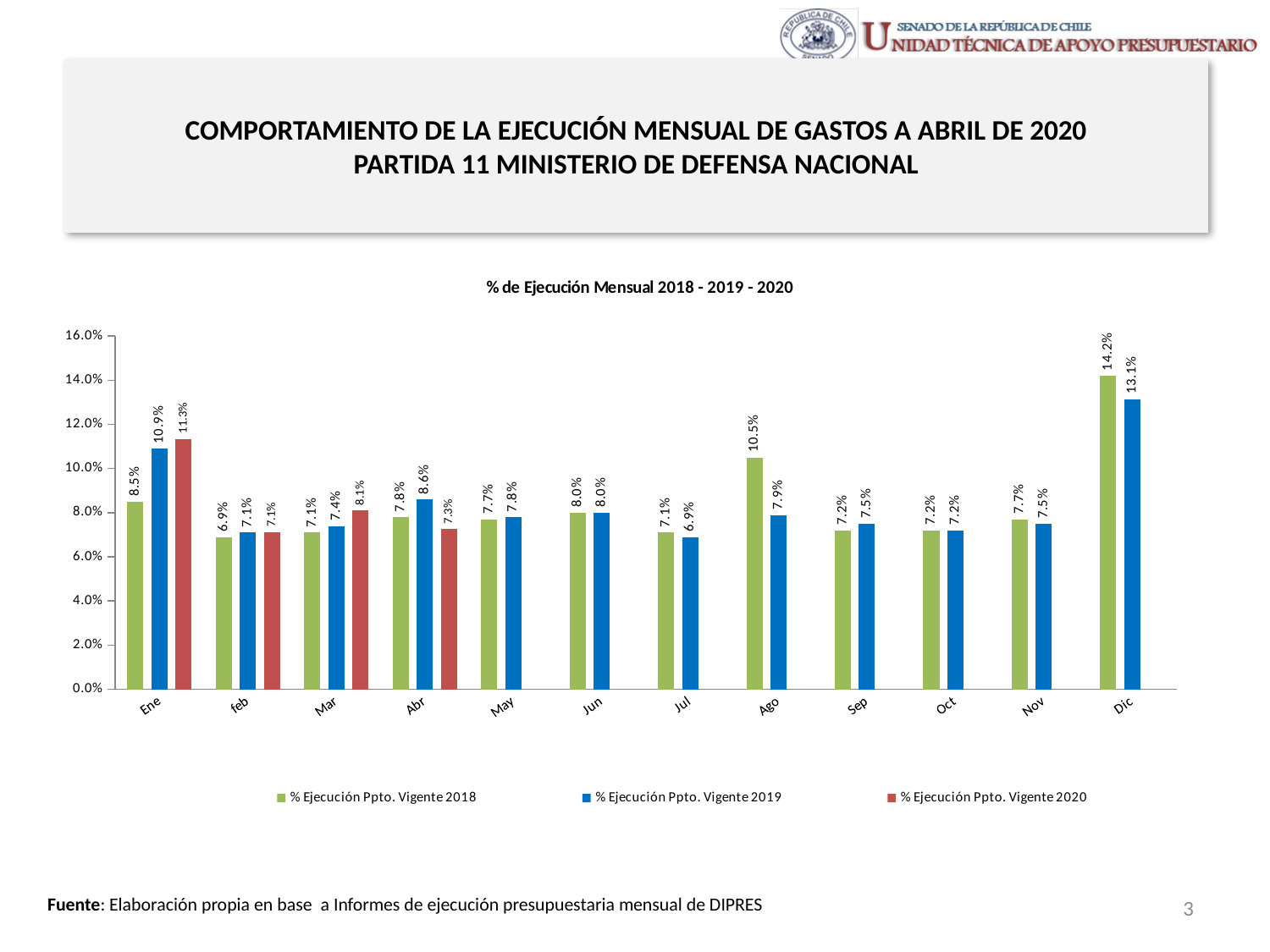
In Abr, which is larger: the 2019 value or the 2020 value? 2019 value (8.6%) What is the value for % Ejecución Ppto. Vigente 2018 in Ago? 10.5% Which month has the highest value for % Ejecución Ppto. Vigente 2018? Dic What is the value for % Ejecución Ppto. Vigente 2019 in Abr? 8.6% How many series does the legend list? 3 Which month has the lowest value for % Ejecución Ppto. Vigente 2019? Jul Is the value for % Ejecución Ppto. Vigente 2018 in Ene greater or less than 10.0%? less How many months are shown on the x axis? 12 What kind of chart is shown on the slide? Bar chart What is the title of the chart? % de Ejecución Mensual 2018 - 2019 - 2020 What is the value for % Ejecución Ppto. Vigente 2020 in Ene? 11.3% What is the difference between the 2018 and 2019 values in Dic? 1.1%